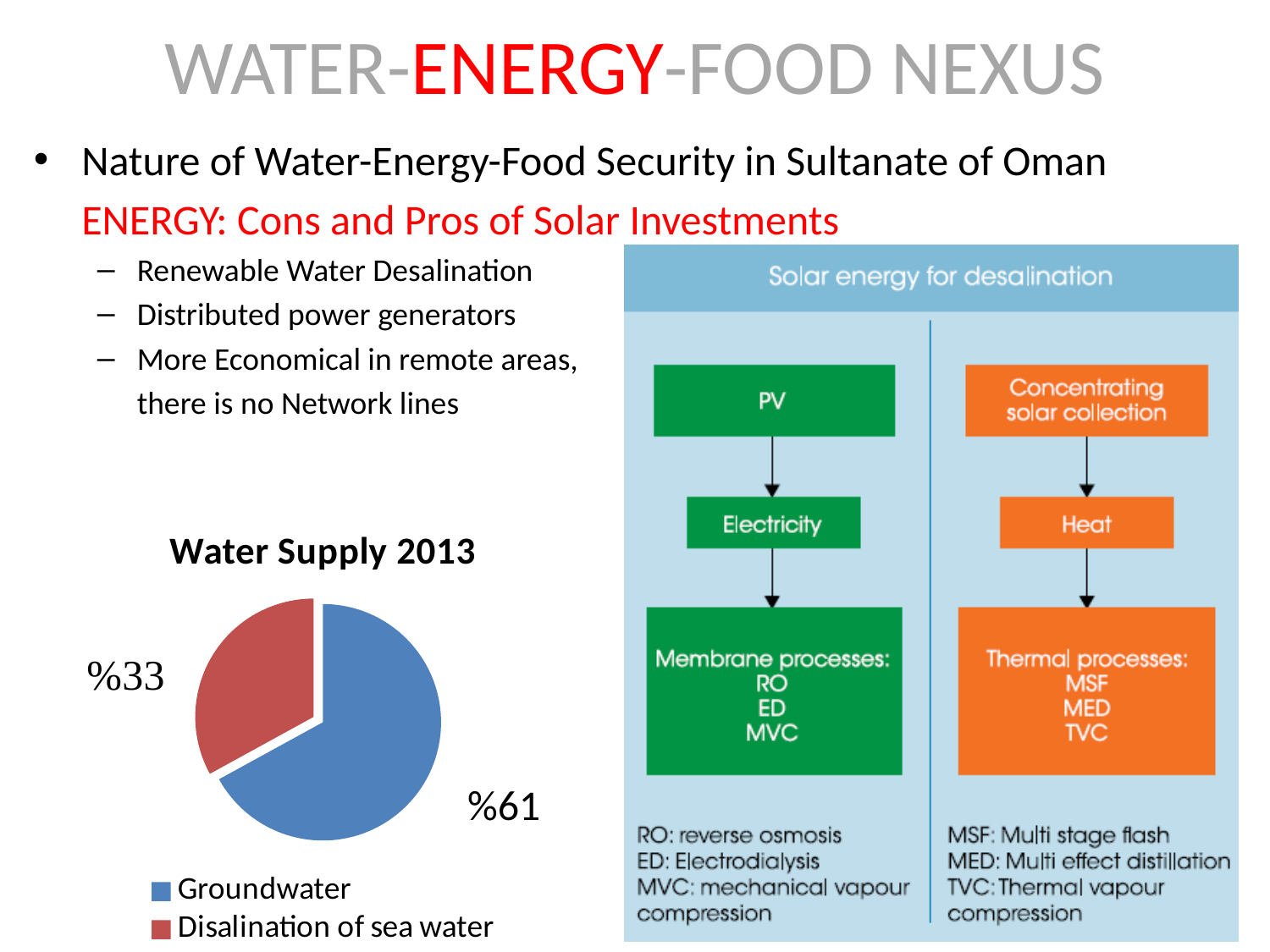
What is the title of the pie chart on the slide? Water Supply 2013 How many entries does the legend of the Water Supply 2013 pie chart list? 2 In the Water Supply 2013 pie chart, which category has the largest slice? Groundwater In the Water Supply 2013 pie chart, what share of the pie does the Disalination of sea water slice represent? %33 In the Water Supply 2013 pie chart, what share is shown for Groundwater? %61 In the Water Supply 2013 pie chart, by how many percentage points does Groundwater exceed Disalination of sea water? 28 In the Water Supply 2013 pie chart, which is larger: Groundwater or Disalination of sea water? Groundwater How many slices does the Water Supply 2013 pie chart have? 2 In the Water Supply 2013 pie chart, which category has the smallest slice? Disalination of sea water What kind of chart is the Water Supply 2013 chart? pie chart In the Water Supply 2013 pie chart, what colour is the Groundwater slice? blue In the Water Supply 2013 pie chart, what share is shown for Disalination of sea water? %33